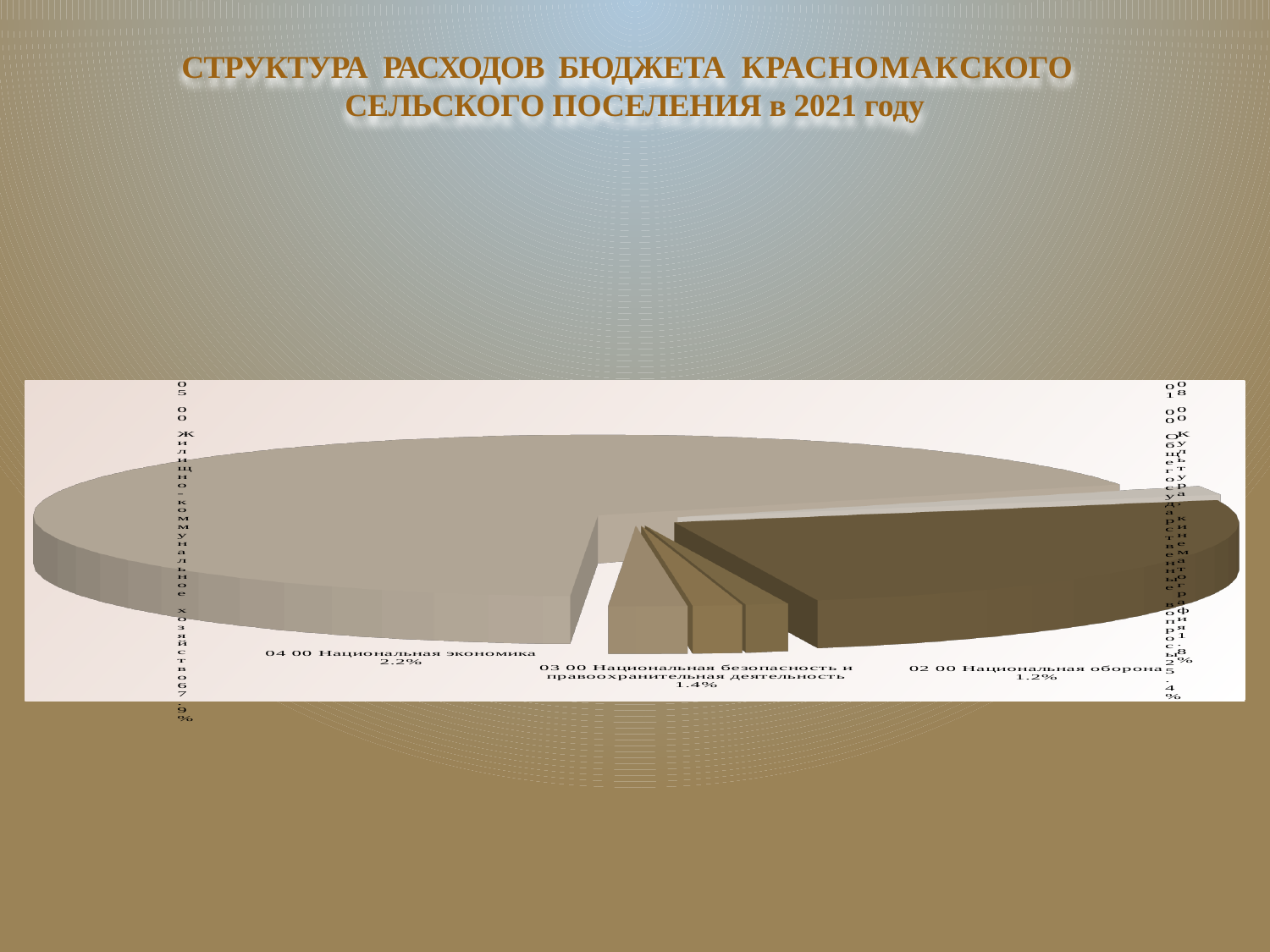
What share of the budget expenditures is labeled for 04 00 Национальная экономика? 2.2% Which has a larger share: 04 00 Национальная экономика or 02 00 Национальная оборона? 04 00 Национальная экономика What share is labeled for 03 00 Национальная безопасность и правоохранительная деятельность? 1.4% What share is labeled for 02 00 Национальная оборона? 1.2% Of the three slices labeled 04 00, 03 00 and 02 00, which has the largest share? 04 00 Национальная экономика What is the difference in percentage points between 04 00 Национальная экономика and 02 00 Национальная оборона? 1.0% What share is labeled for 05 00 Жилищно-коммунальное хозяйство? 67.9% Which has a larger share: 03 00 Национальная безопасность и правоохранительная деятельность or 02 00 Национальная оборона? 03 00 Национальная безопасность и правоохранительная деятельность Of the three slices labeled 04 00, 03 00 and 02 00, which has the smallest share? 02 00 Национальная оборона What is the difference in percentage points between 04 00 Национальная экономика and 03 00 Национальная безопасность и правоохранительная деятельность? 0.8% What is the title of the slide containing the chart? СТРУКТУРА РАСХОДОВ БЮДЖЕТА КРАСНОМАКСКОГО СЕЛЬСКОГО ПОСЕЛЕНИЯ в 2021 году What kind of chart is shown on the slide? pie chart